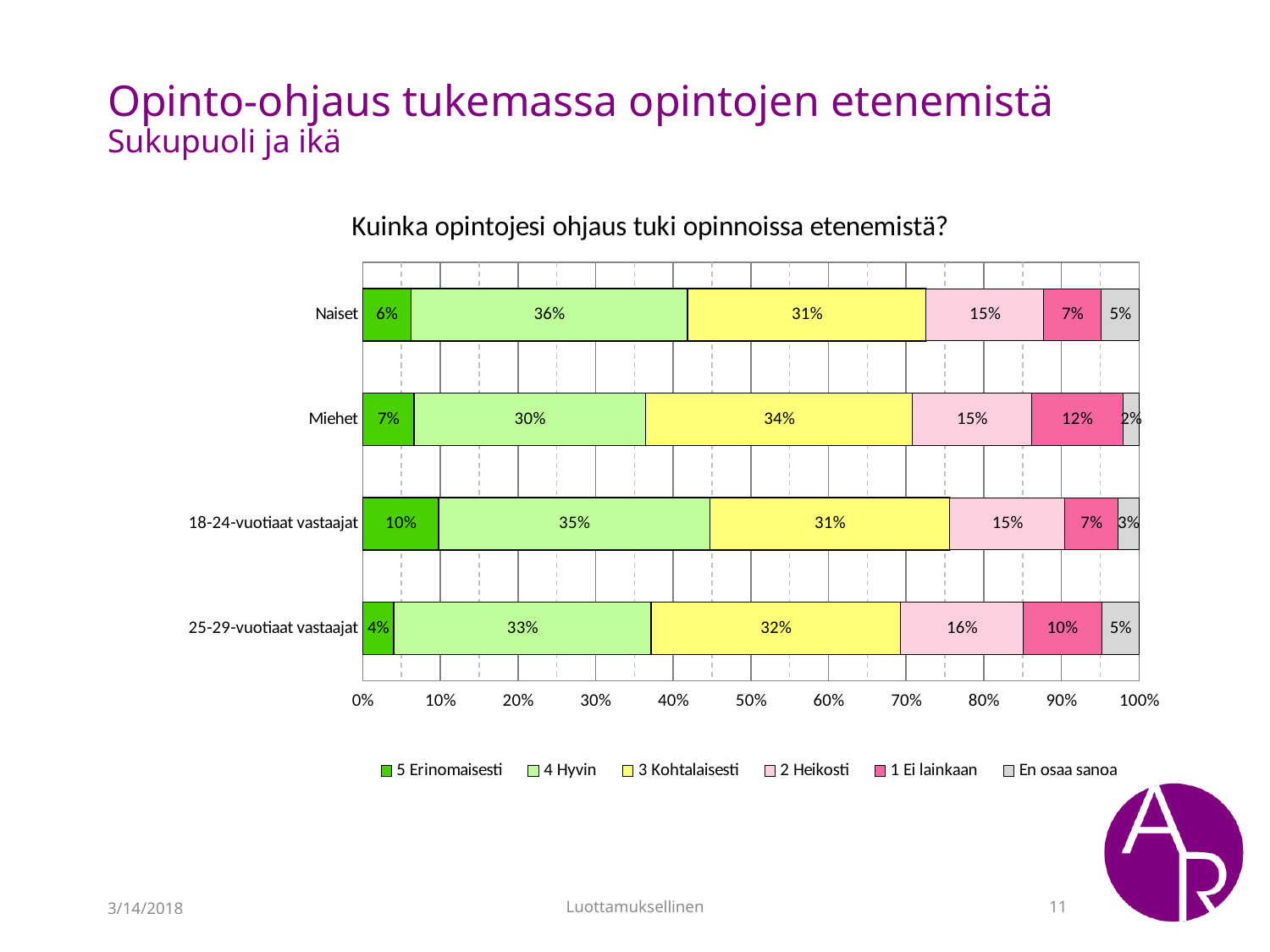
What is the title of the chart? Kuinka opintojesi ohjaus tuki opinnoissa etenemistä? What percentage of Naiset answered "4 Hyvin"? 36% What percentage of 18-24-vuotiaat vastaajat answered "5 Erinomaisesti"? 10% What is the difference between the "1 Ei lainkaan" share for Miehet and for Naiset? 5% What kind of chart is shown on the slide? Stacked bar chart Which category has the lowest share of "5 Erinomaisesti" responses? 25-29-vuotiaat vastaajat Which has a larger "3 Kohtalaisesti" share, Naiset or Miehet? Miehet What percentage of 25-29-vuotiaat vastaajat answered "2 Heikosti"? 16% What percentage of Miehet answered "1 Ei lainkaan"? 12% How many series does the legend list? 6 Which category has the highest share of "5 Erinomaisesti" responses? 18-24-vuotiaat vastaajat How many categories (bars) are shown in the chart? 4